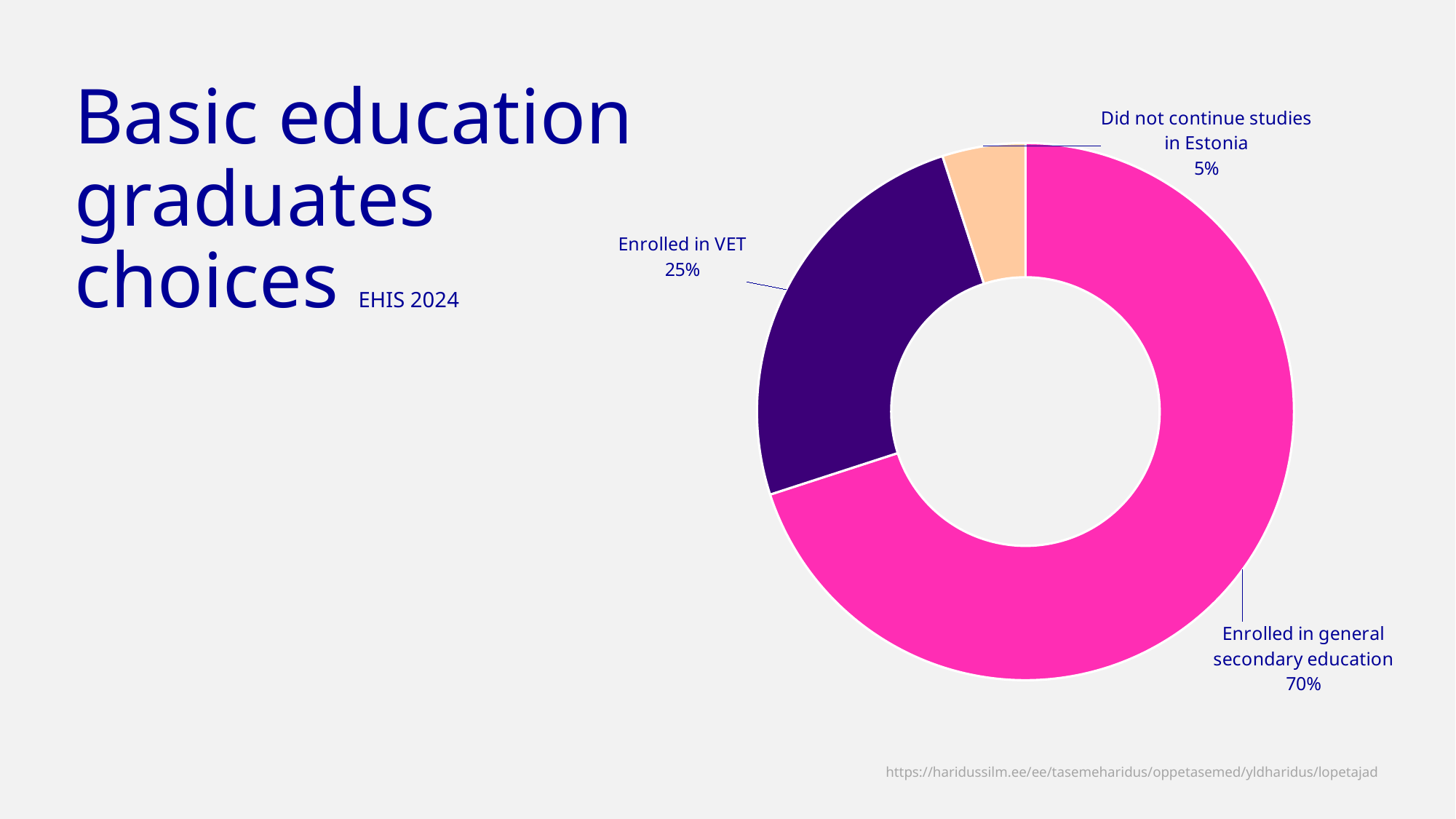
What is the difference in percentage points between the share enrolled in general secondary education and the share enrolled in VET? 45 What kind of chart is shown on the slide? Doughnut (pie) chart Which is larger: the share enrolled in VET or the share that did not continue studies in Estonia? Enrolled in VET What is the title of the slide? Basic education graduates choices What share of basic education graduates did not continue studies in Estonia? 5% How many categories are shown in the chart? 3 What share of basic education graduates enrolled in general secondary education? 70% What is the difference in percentage points between the share enrolled in VET and the share that did not continue studies in Estonia? 20 What colour is the slice for Enrolled in VET? Dark purple What share of basic education graduates enrolled in VET? 25% Which category has the largest share of the chart? Enrolled in general secondary education Which category has the smallest share of the chart? Did not continue studies in Estonia